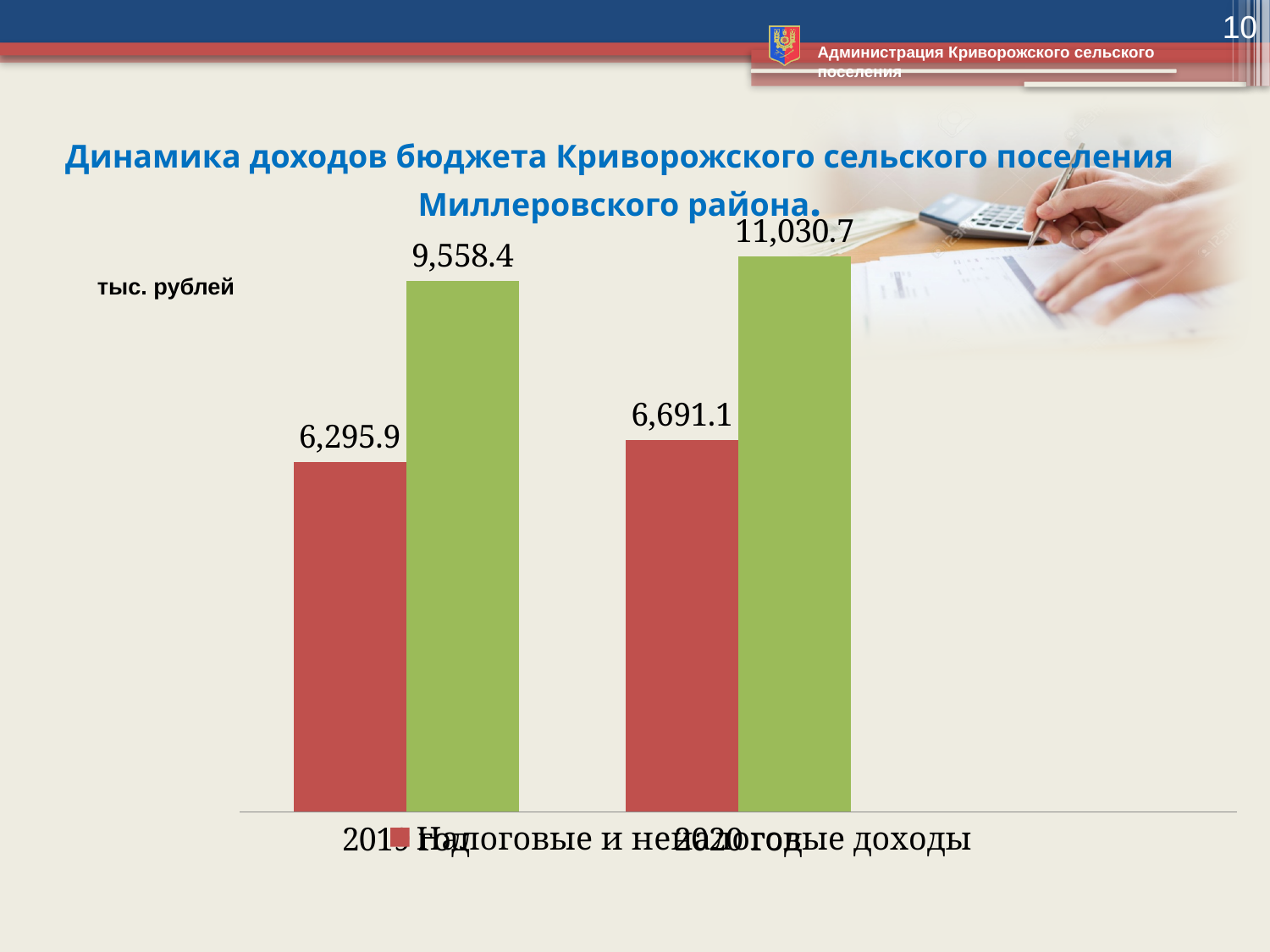
What is the difference between the red bar for 2020 год and the red bar in the left group? 395.2 What is the difference between the green and red bars for 2020 год? 4,339.6 In what units are the values on the chart given? тыс. рублей What is the value of the green bar in the left group of bars? 9,558.4 What type of chart is shown on the slide? Bar chart What is the value of the green bar for 2020 год? 11,030.7 Which bar has the lowest value on the chart? The red bar in the left group (6,295.9) Which bar has the highest value on the chart? The green bar for 2020 год (11,030.7) Which is larger: the red bar for 2020 год or the red bar in the left group? The red bar for 2020 год By how much does the green bar for 2020 год exceed the green bar in the left group? 1,472.3 What is the value of the red bar for 2020 год? 6,691.1 What is the value of the red bar in the left group of bars? 6,295.9